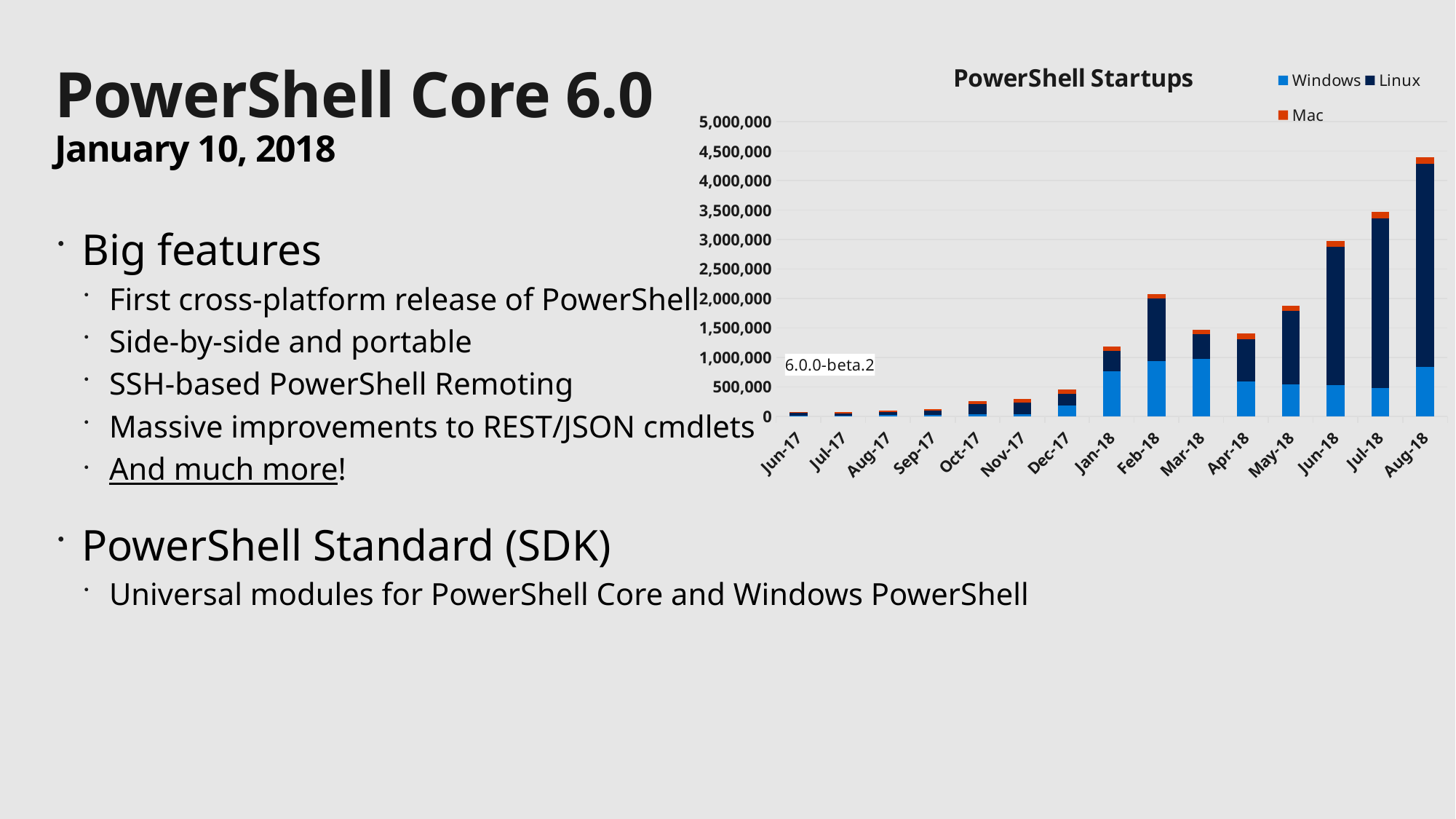
Do the total startups generally rise or fall from Jun-17 to Aug-18? Rise What kind of chart is shown on the slide? Stacked bar chart Is the total value for Jul-18 greater or less than 3,000,000? greater How many series does the chart legend list? 3 Is the total value for Aug-18 greater or less than 4,000,000? greater Which month has the highest total startups in the chart? Aug-18 Which series is shown in the dark navy colour in the chart? Linux Is the total value for Jan-18 greater or less than 1,000,000? greater How many months are shown on the x axis of the chart? 15 What is the title of the chart? PowerShell Startups Which month has the larger total, Feb-18 or Mar-18? Feb-18